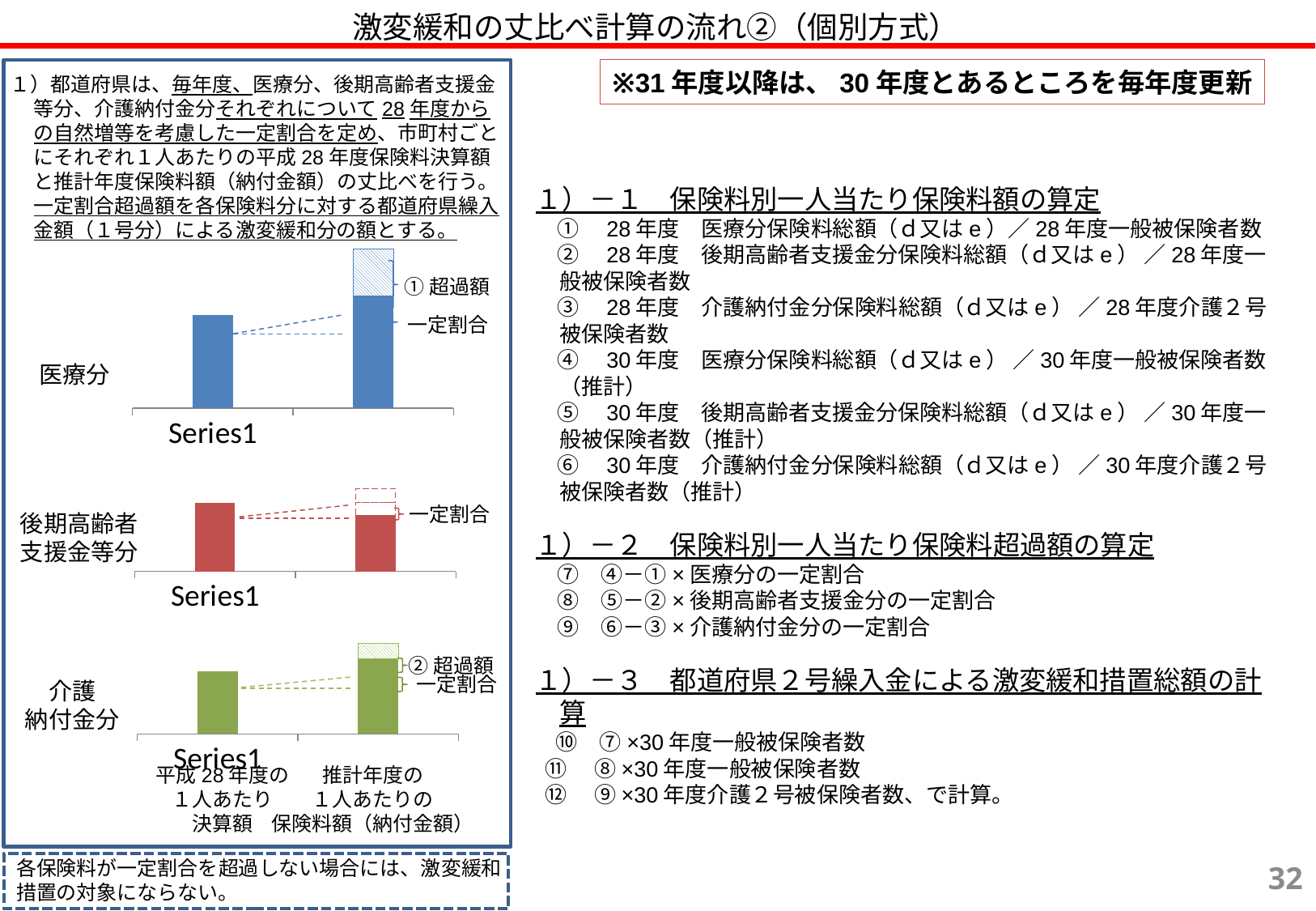
What series label is printed below each of the three bar charts? Series1 In the 後期高齢者支援金等分 chart, do the solid bars rise or fall from left to right? fall How many bars does the 医療分 chart show? 2 How many separate bar charts are shown on the left side of the slide? 3 What colour are the bars in the 医療分 chart? blue In the 介護納付金分 chart, which bar is taller: the left bar (平成28年度) or the right bar (推計年度)? the right bar (推計年度) In the 医療分 chart, do the bars rise or fall from left to right? rise In the 介護納付金分 chart, do the bars rise or fall from left to right? rise In the 後期高齢者支援金等分 chart, which solid bar is taller: the left bar (平成28年度) or the right bar (推計年度)? the left bar (平成28年度) What kind of chart is the 医療分 chart on the left of the slide? bar chart In the 医療分 chart, which bar is taller: the left bar (平成28年度の1人あたり決算額) or the right bar (推計年度の1人あたり保険料額)? the right bar (推計年度の1人あたり保険料額)